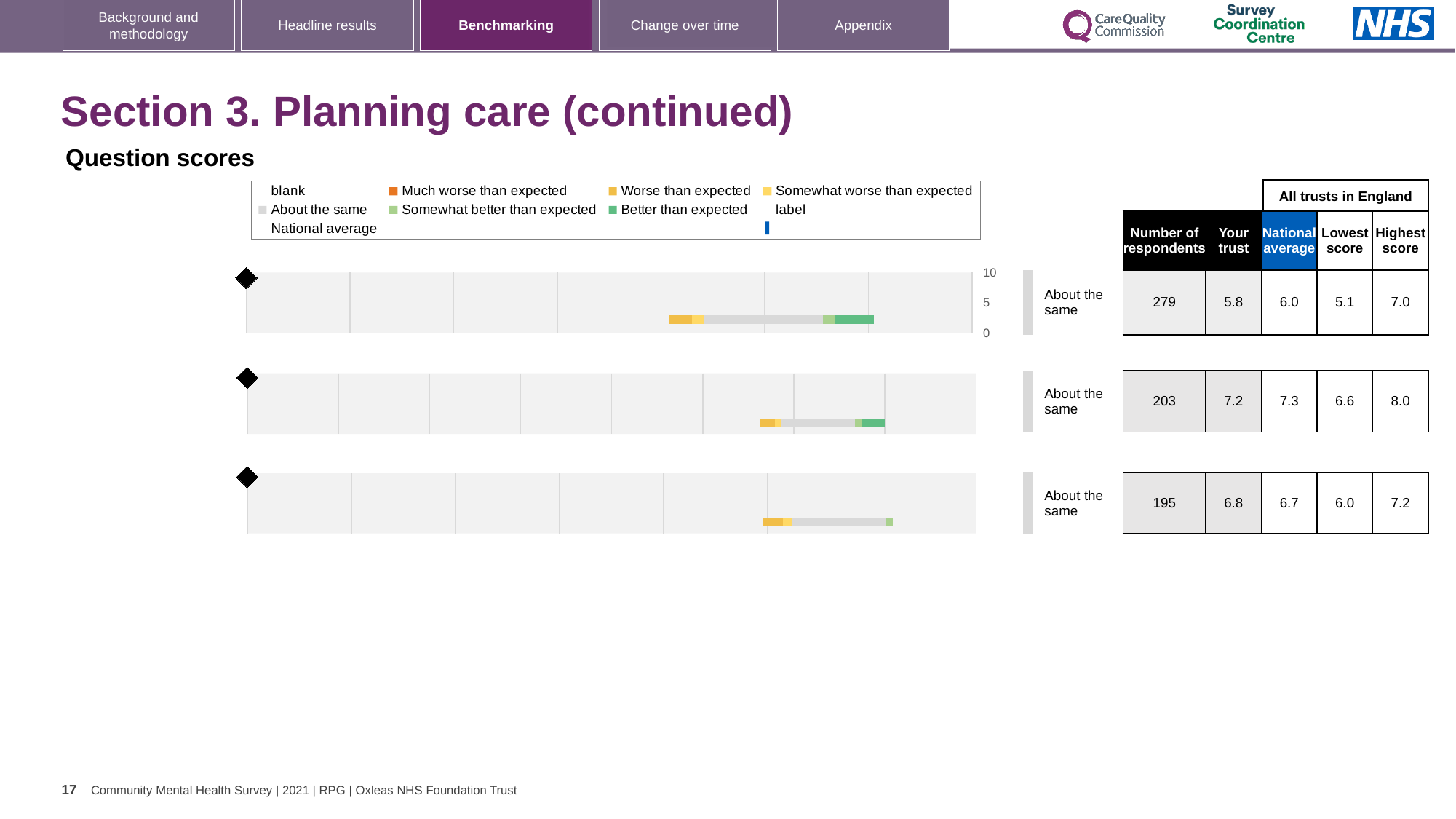
For the bottom chart, is the 'Your trust' score or the national average score larger? Your trust For the middle chart, what is the number of respondents? 203 What is the maximum value shown on the axis of the top chart? 10 For the middle chart, what is the difference between the highest score and the lowest score? 1.4 What benchmark category label is shown next to the top chart? About the same How many benchmarking charts are shown on the slide? 3 Which of the three charts has the highest 'Your trust' score? the middle chart What kind of chart is used for the question scores on this slide? bar chart Which of the three charts has the lowest number of respondents? the bottom chart For the top chart, what is the national average score? 6.0 For the bottom chart, what is the highest score among all trusts in England? 7.2 For the top chart, what is the 'Your trust' score? 5.8